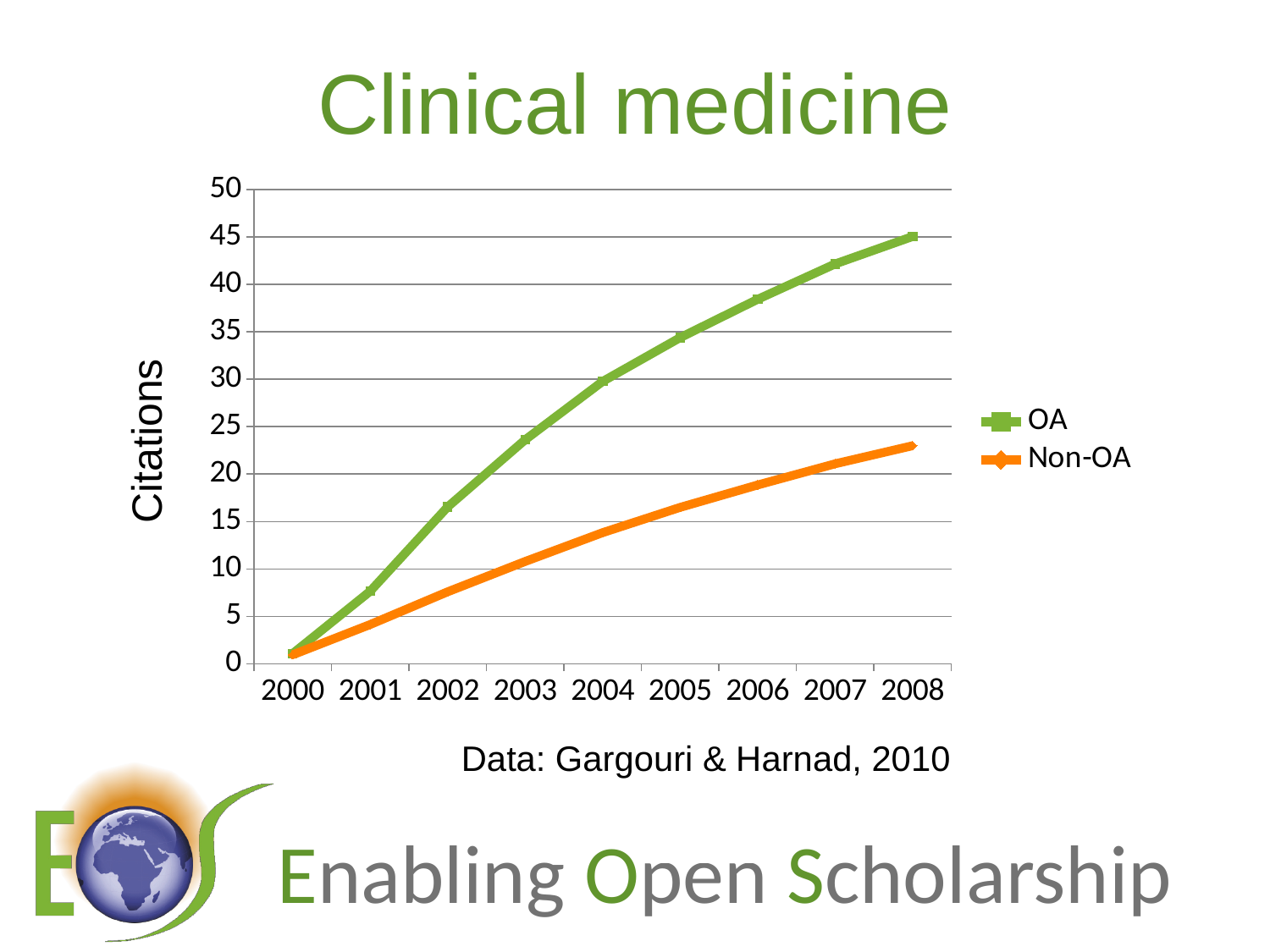
Do the Non-OA citations rise or fall from 2000 to 2008? rise How many years are shown along the x axis? 9 In 2008, which series has more citations, OA or Non-OA? OA Do the OA citations rise or fall from 2000 to 2008? rise What kind of chart is shown on the slide? line chart How many series does the legend list? 2 Is the OA value for 2008 greater or less than 40? greater In which year does the OA series reach its highest value? 2008 Is the OA value for 2003 greater or less than 20? greater Is the Non-OA value for 2004 greater or less than 20? less What is the label on the y axis? Citations